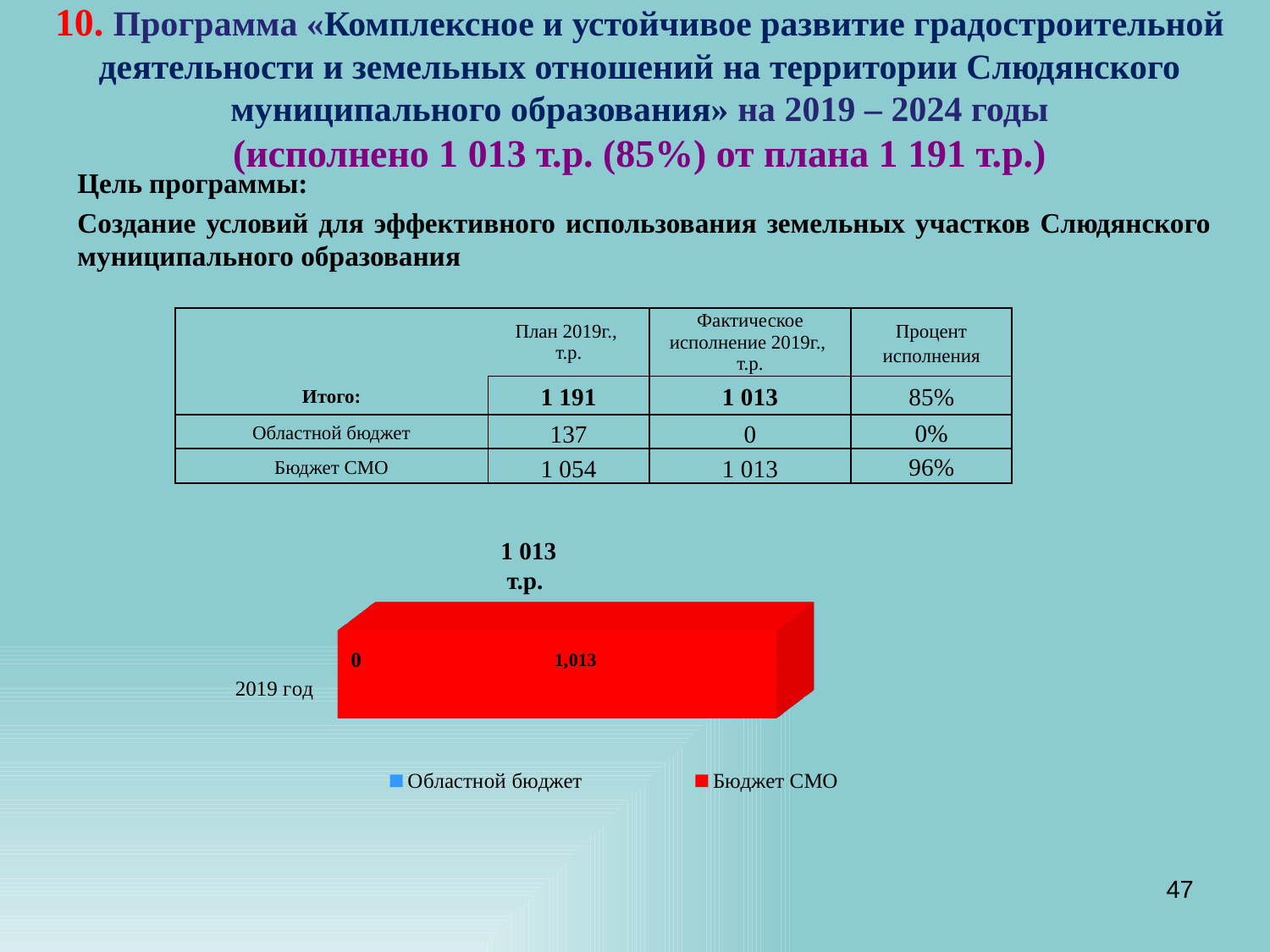
What is the title shown above the chart? 1 013 т.р. What is the value of the Областной бюджет series for 2019 год in the chart? 0 How many series does the chart legend list? 2 What is the value of the Бюджет СМО series for 2019 год in the chart? 1,013 What is the total of the stacked bar for 2019 год? 1,013 What is the difference between the Бюджет СМО and Областной бюджет values for 2019 год? 1,013 Which series has the larger value for 2019 год, Областной бюджет or Бюджет СМО? Бюджет СМО What is the category label on the chart's axis? 2019 год How many categories are plotted on the chart? 1 What kind of chart is shown on the slide? bar chart What colour represents the Бюджет СМО series in the chart? red Which series has the lowest value in the chart? Областной бюджет